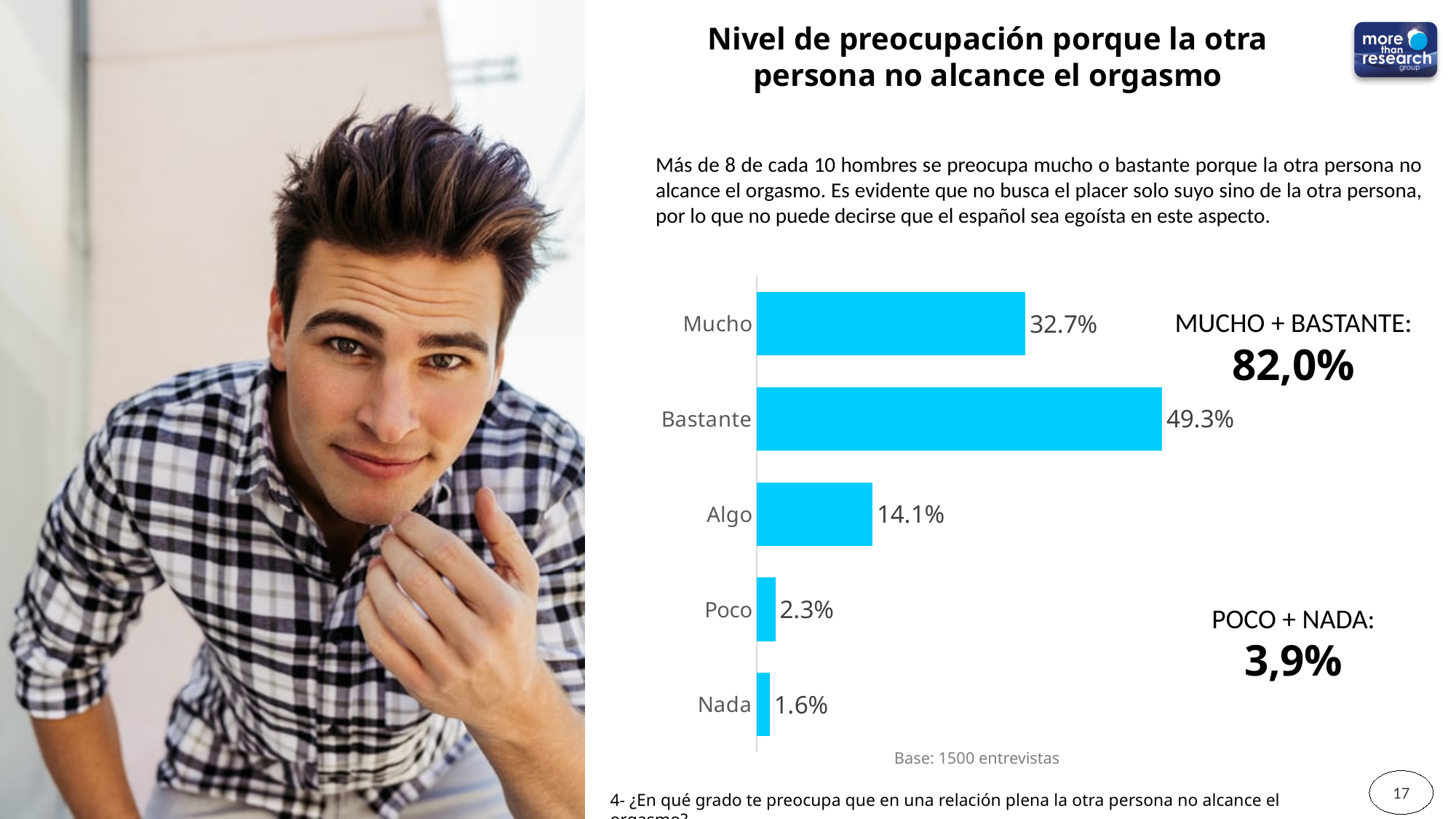
What is the combined value shown for MUCHO + BASTANTE? 82,0% What is the value for Nada? 1.6% What is the difference between the values for Bastante and Mucho? 16.6% What is the title of the chart? Nivel de preocupación porque la otra persona no alcance el orgasmo What is the value for Bastante? 49.3% Which is larger, the value for Algo or the value for Poco? Algo Which category has the highest value? Bastante How many categories are shown in the chart? 5 What kind of chart is shown on the slide? Bar chart What is the value for Algo? 14.1% Which category has the lowest value? Nada What is the value for Mucho? 32.7%